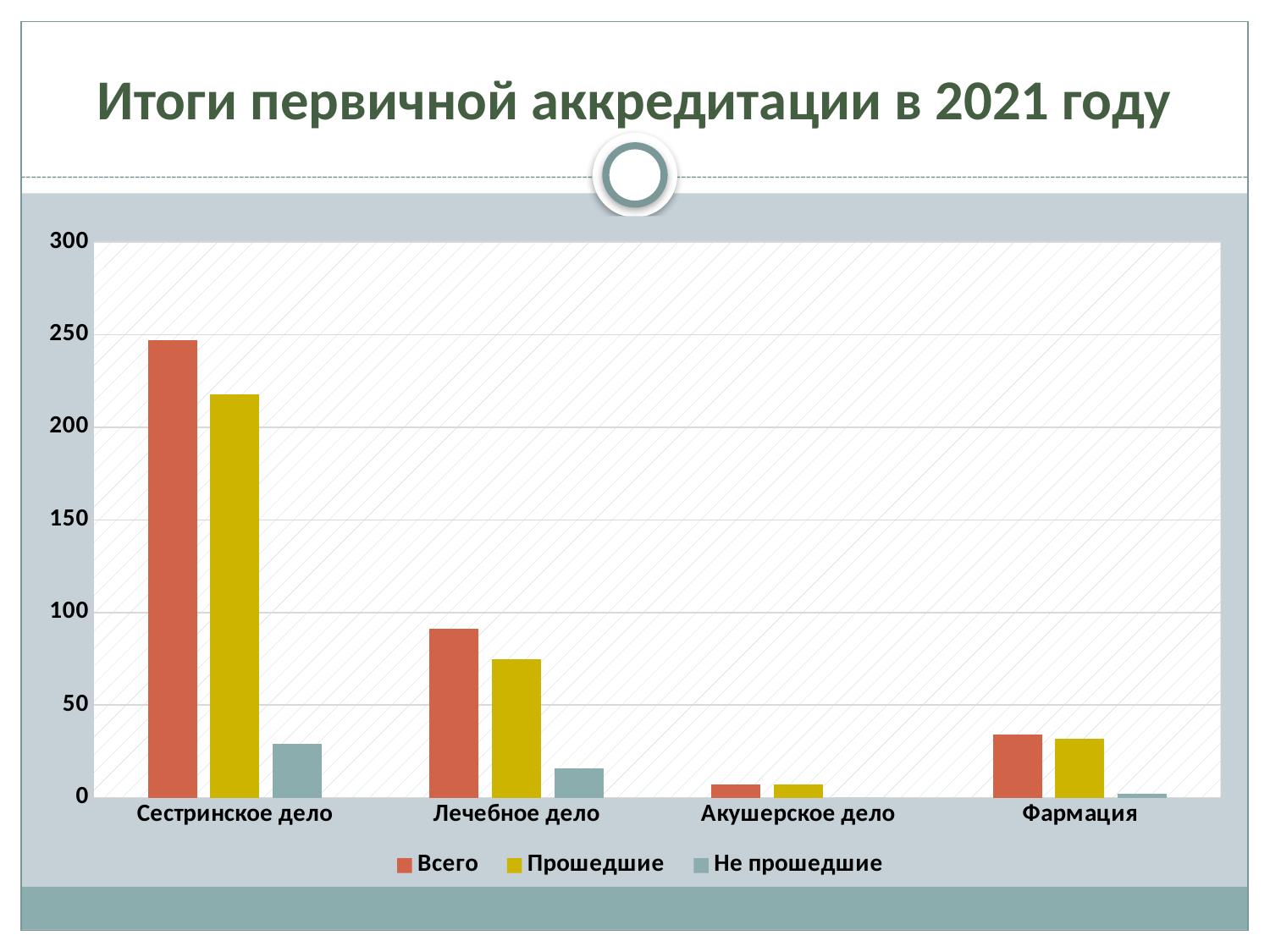
Is the value for Всего in Фармация greater or less than 50? less Which category has the lowest value for Всего? Акушерское дело Is the value for Всего in Сестринское дело greater or less than 200? greater Is the value for Прошедшие in Лечебное дело greater or less than 100? less What kind of chart is shown on the slide? bar chart What is the title of the slide? Итоги первичной аккредитации в 2021 году Which category has the highest value for Всего? Сестринское дело Which series is shown in yellow in the legend? Прошедшие How many categories are shown on the x axis? 4 How many series does the legend list? 3 Which is larger: Всего for Лечебное дело or Всего for Фармация? Лечебное дело